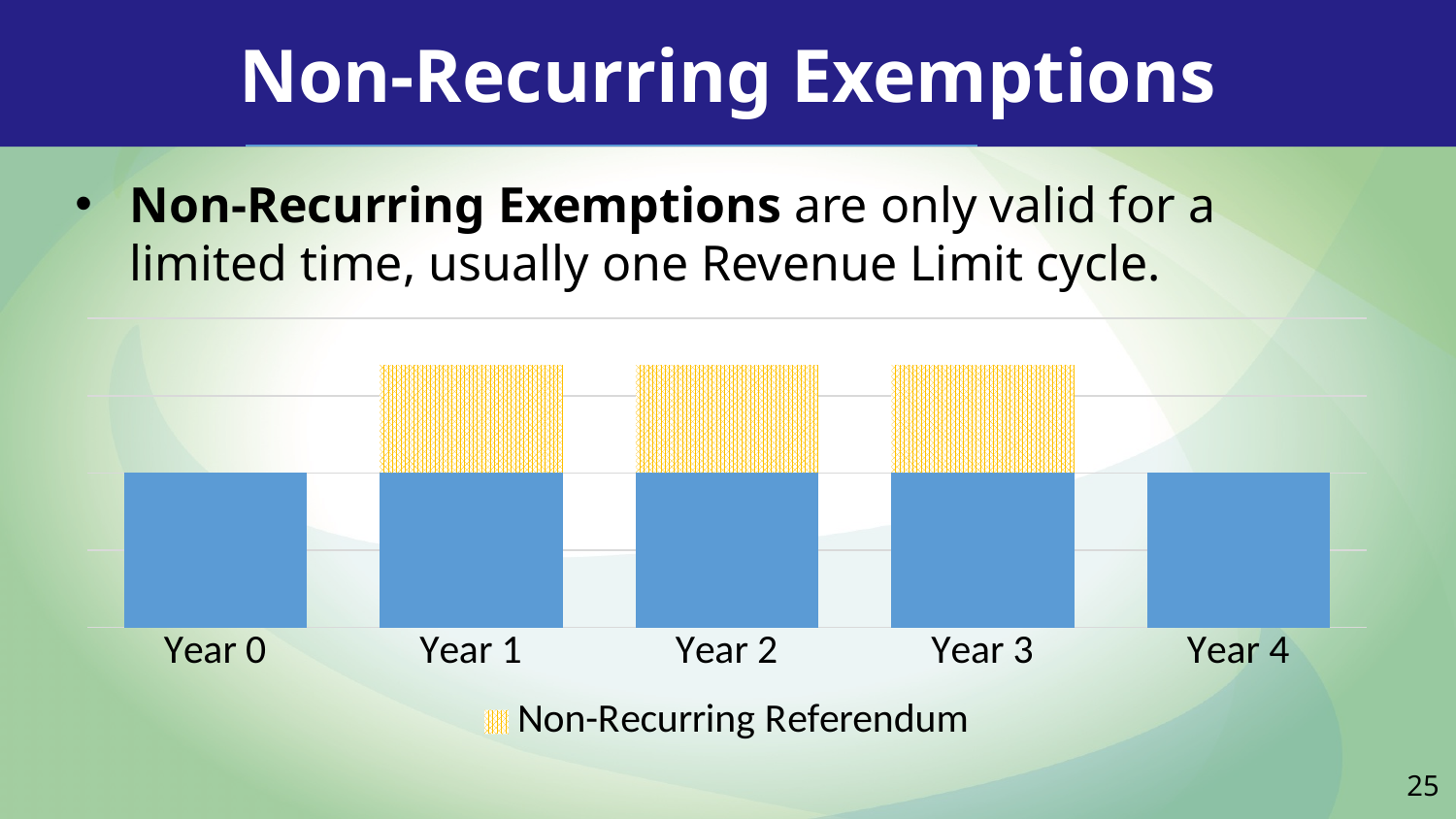
Which years have no Non-Recurring Referendum segment? Year 0 and Year 4 Does the total bar height rise or fall from Year 3 to Year 4? Fall Which is taller overall, the bar for Year 0 or the bar for Year 1? Year 1 What is the name of the series listed in the chart's legend? Non-Recurring Referendum What colour is the Non-Recurring Referendum segment in the chart? Yellow (patterned) How many year categories are shown on the x axis of the chart? 5 How many bars include a Non-Recurring Referendum segment? 3 Which years have a Non-Recurring Referendum segment stacked on top of the blue bar? Year 1, Year 2, Year 3 Does the total bar height rise or fall from Year 0 to Year 1? Rise What kind of chart is shown on the slide? Stacked bar chart Which is taller overall, the bar for Year 2 or the bar for Year 4? Year 2 How many series does the chart's legend list? 1